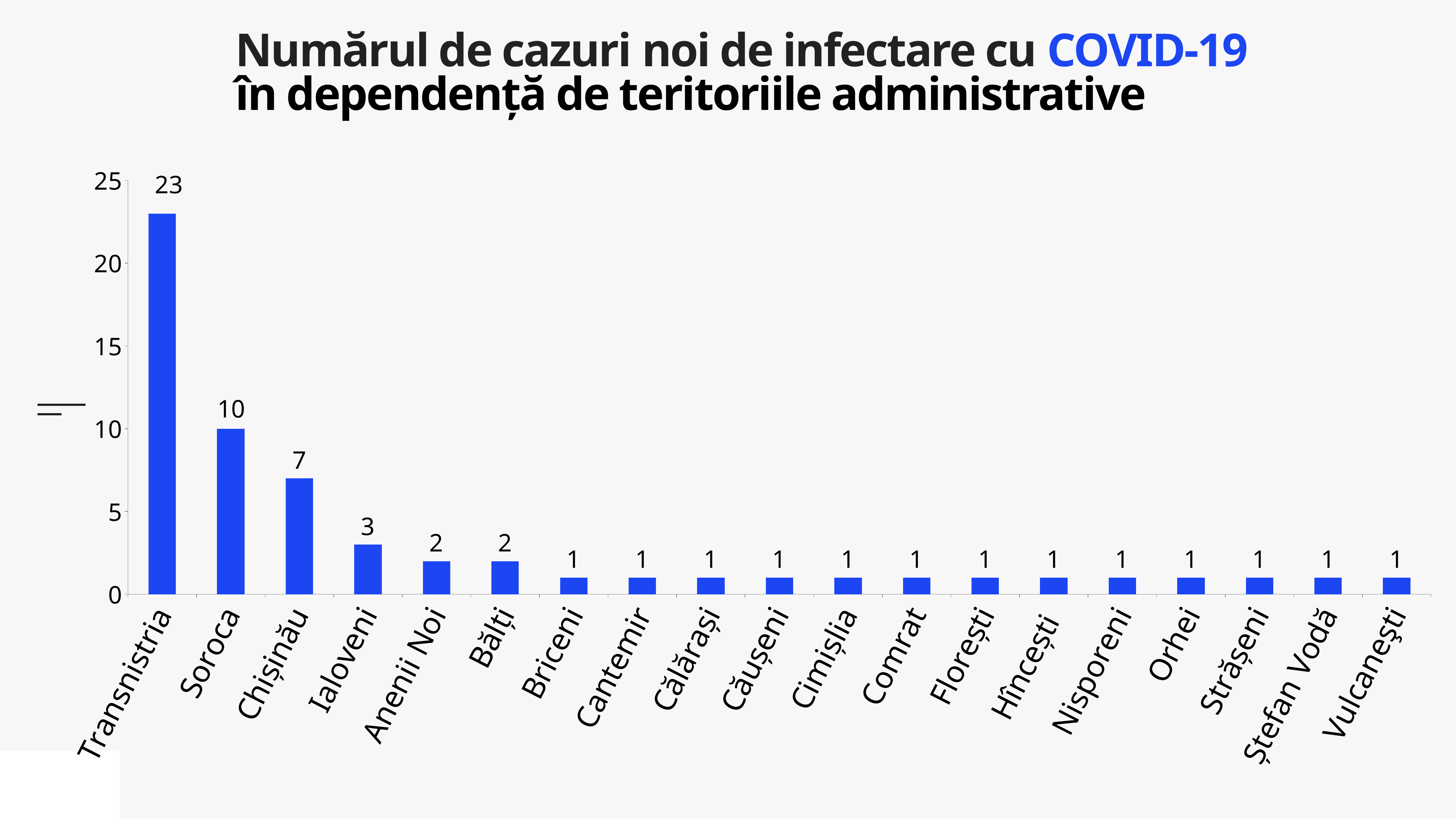
Which is larger, the value for Chișinău or the value for Ialoveni? Chișinău What kind of chart is shown on the slide? bar chart What is the value for Transnistria? 23 How many territories are shown on the x axis? 19 Do the values rise or fall from left to right along the x axis? fall What is the value for Bălți? 2 Which territory has the highest number of new cases? Transnistria What is the difference between the values for Transnistria and Soroca? 13 What is the value for Soroca? 10 What is the value for Ialoveni? 3 What is the value for Chișinău? 7 Is the value for Transnistria greater or less than 20? greater